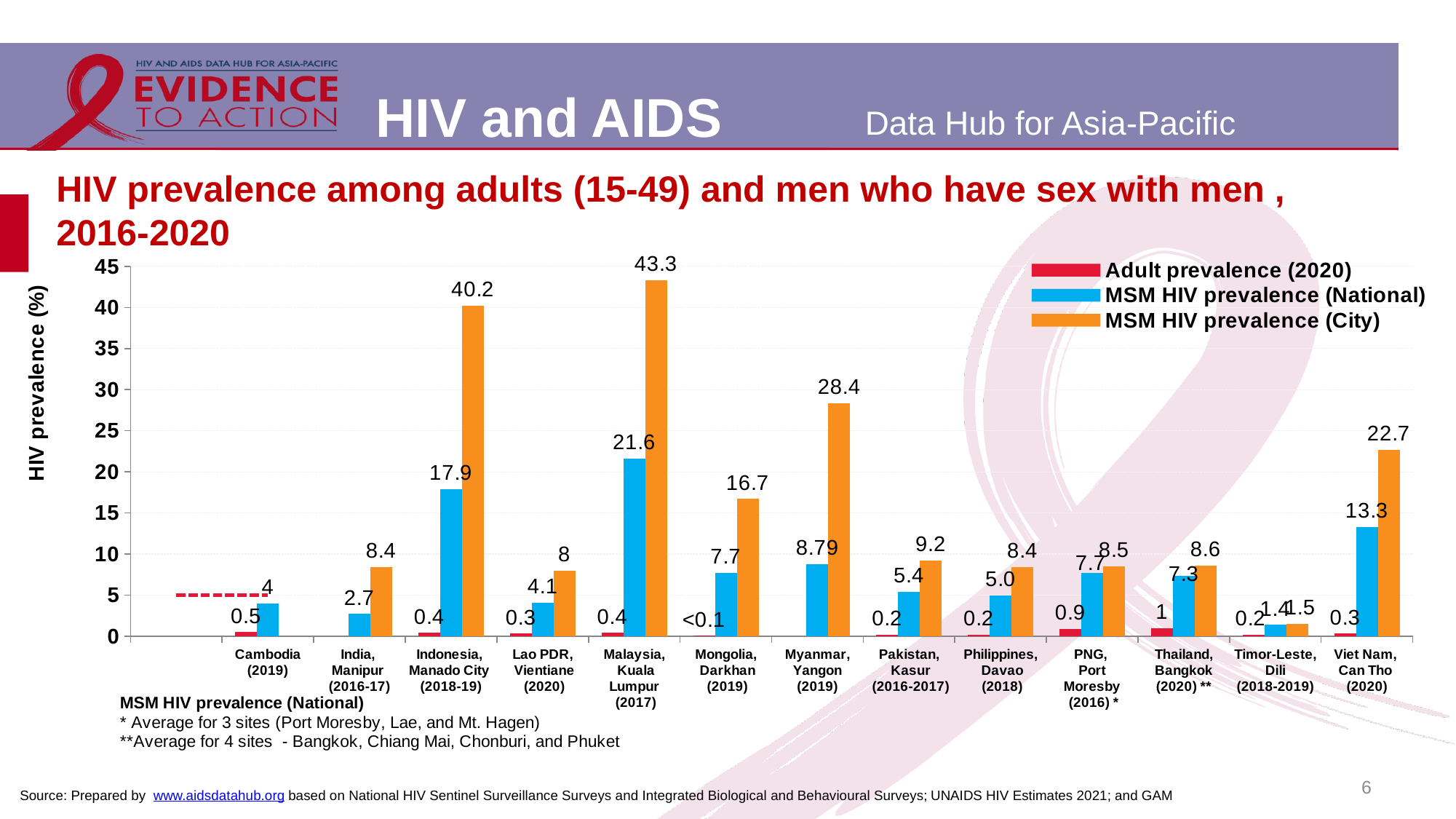
How many series does the chart legend list? 3 What is the Adult prevalence (2020) value shown for Thailand, Bangkok (2020)? 1 Which is larger: the MSM HIV prevalence (City) value for Indonesia, Manado City or for Myanmar, Yangon? Indonesia, Manado City Which location has the highest MSM HIV prevalence (City) value? Malaysia, Kuala Lumpur (2017) What is the MSM HIV prevalence (National) value for Indonesia, Manado City (2018-19)? 17.9 How many locations are shown on the x axis of the chart? 13 What is the label of the y axis of the chart? HIV prevalence (%) What is the MSM HIV prevalence (National) value for Myanmar, Yangon (2019)? 8.79 What is the difference between the MSM HIV prevalence (City) and MSM HIV prevalence (National) values for Viet Nam, Can Tho (2020)? 9.4 What is the MSM HIV prevalence (City) value for Malaysia, Kuala Lumpur (2017)? 43.3 Which location has the lowest MSM HIV prevalence (National) value? Timor-Leste, Dili (2018-2019) What kind of chart is shown on the slide? Bar chart